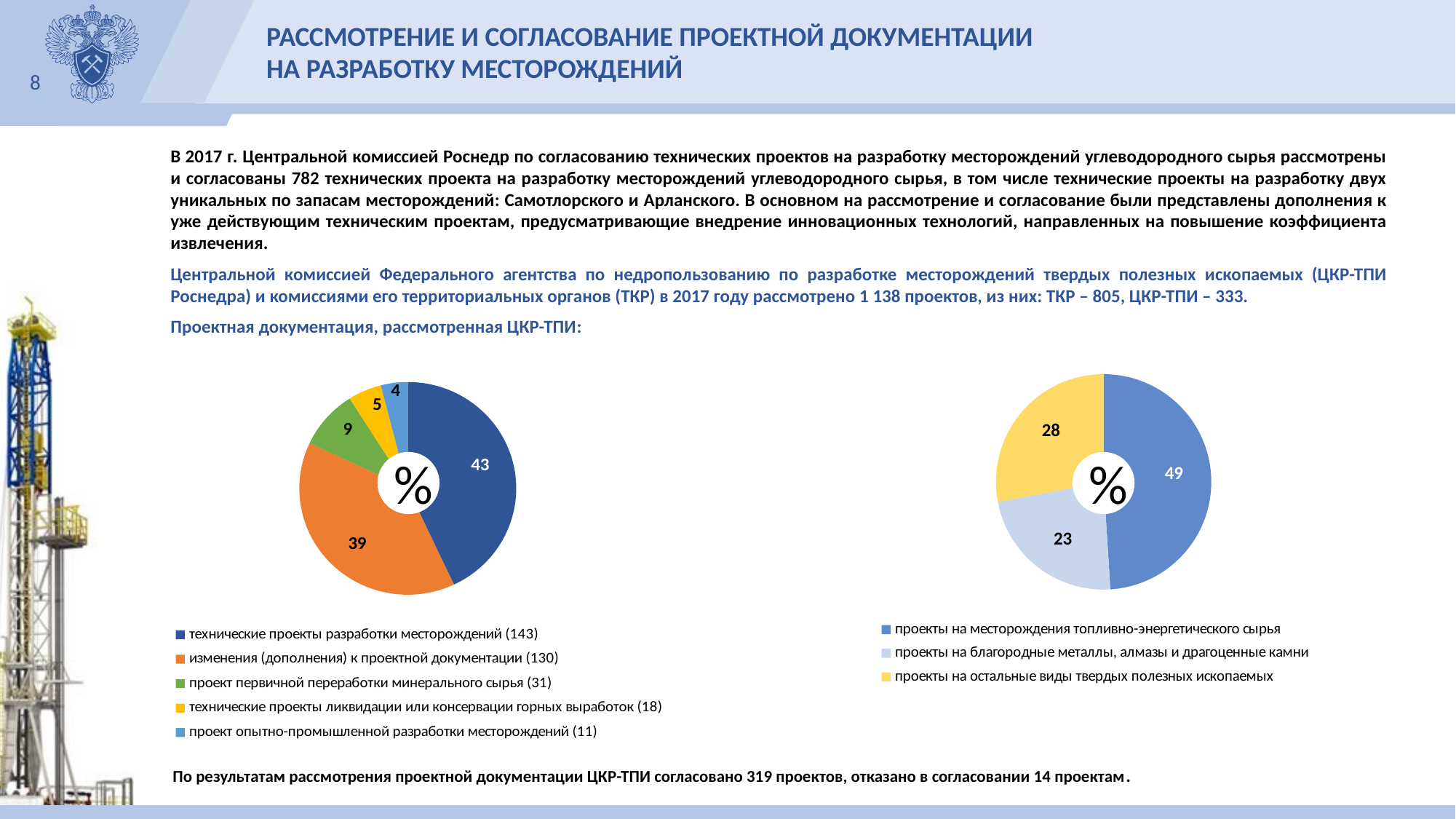
What symbol is displayed in the centre of each pie chart? % In the left pie chart, what percentage is shown for 'изменения (дополнения) к проектной документации'? 39 In the left pie chart, what is the difference between the percentages for 'проект первичной переработки минерального сырья' and 'технические проекты ликвидации или консервации горных выработок'? 4 How many categories does the legend of the left pie chart list? 5 In the right pie chart, what percentage is shown for 'проекты на благородные металлы, алмазы и драгоценные камни'? 23 In the right pie chart, what percentage is shown for 'проекты на месторождения топливно-энергетического сырья'? 49 How many categories does the legend of the right pie chart list? 3 In the left pie chart, which category has the largest slice? технические проекты разработки месторождений (143) In the right pie chart, which is larger: the slice for 'проекты на остальные виды твердых полезных ископаемых' or the slice for 'проекты на благородные металлы, алмазы и драгоценные камни'? проекты на остальные виды твердых полезных ископаемых What type of chart is shown on the left side of the slide? pie chart In the left pie chart, which category has the smallest slice? проект опытно-промышленной разработки месторождений (11) In the left pie chart, what percentage is shown for the slice 'технические проекты разработки месторождений'? 43